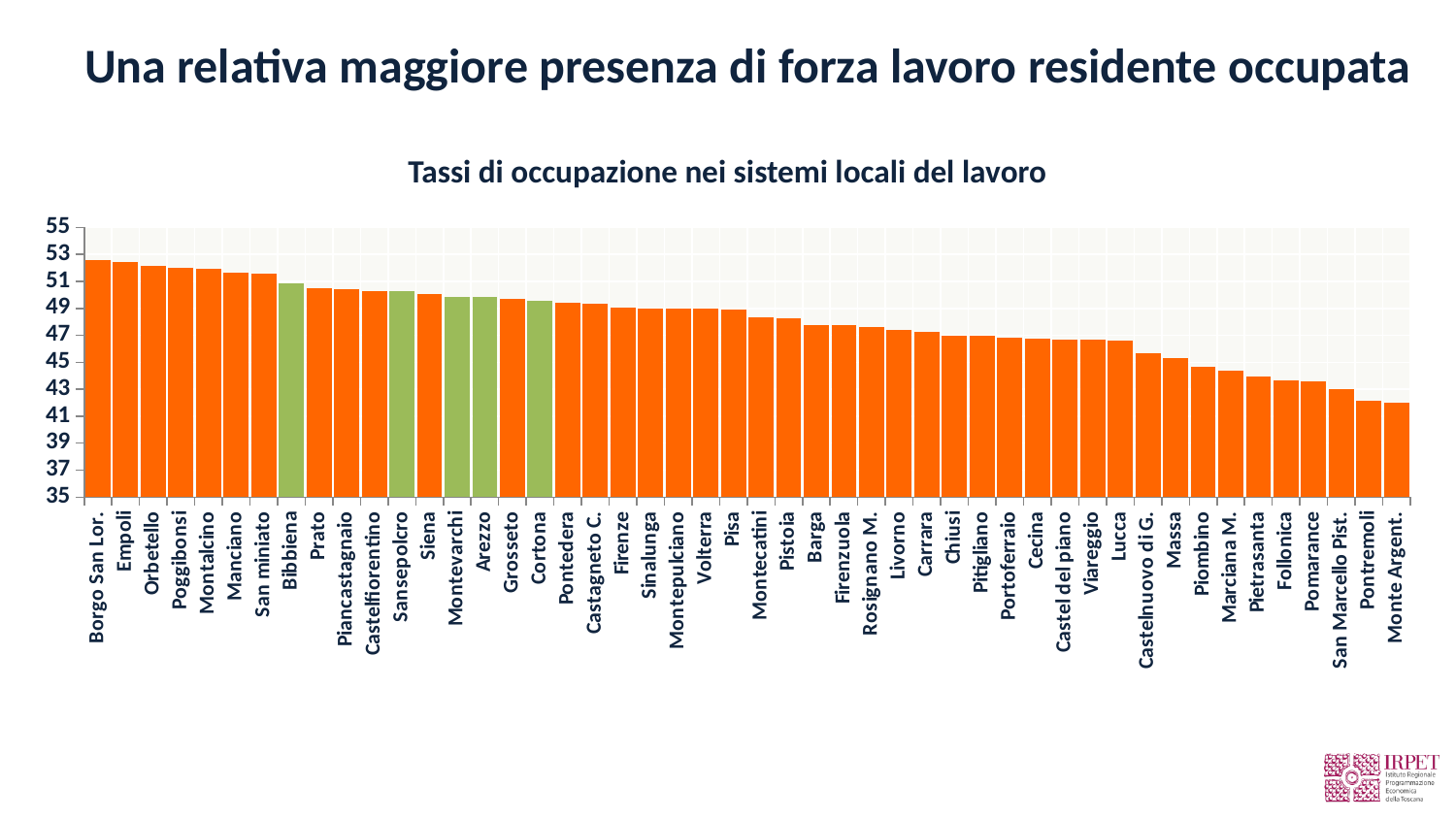
Is the value for Borgo San Lor. greater or less than 51? greater Which local labour system has the highest employment rate in the chart? Borgo San Lor. Is the value for Firenze greater or less than 47? greater What kind of chart is shown on the slide? bar chart How many local labour systems are plotted in the chart? 48 How many bars are coloured green rather than orange? 5 Which local labour system has the lowest employment rate in the chart? Monte Argent. Is the value for Lucca greater or less than 49? less What is the title of the chart? Tassi di occupazione nei sistemi locali del lavoro Do the values rise or fall moving from left to right along the x axis? fall Which has the larger value, Empoli or Pisa? Empoli